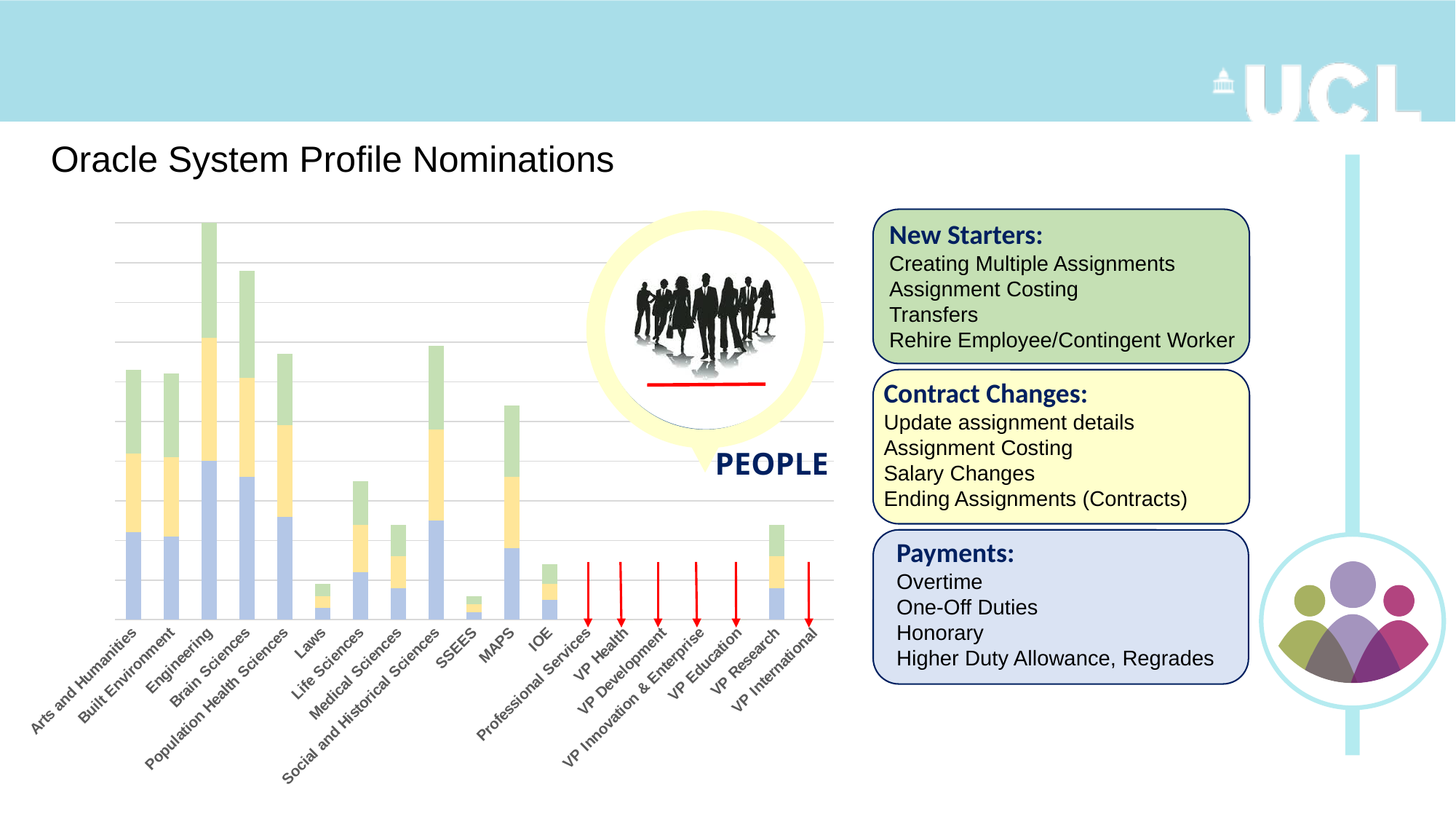
Which bar is taller, Engineering or Brain Sciences? Engineering What kind of chart is shown on the slide? Stacked bar chart Which bar is taller, MAPS or IOE? MAPS Which bar is taller, Arts and Humanities or Laws? Arts and Humanities How many categories are listed along the x axis of the chart? 19 How many categories on the x axis are marked with a red arrow instead of a bar? 6 Which category has the second tallest bar in the chart? Brain Sciences Which category has the tallest bar in the chart? Engineering How many coloured segments make up each stacked bar in the chart? 3